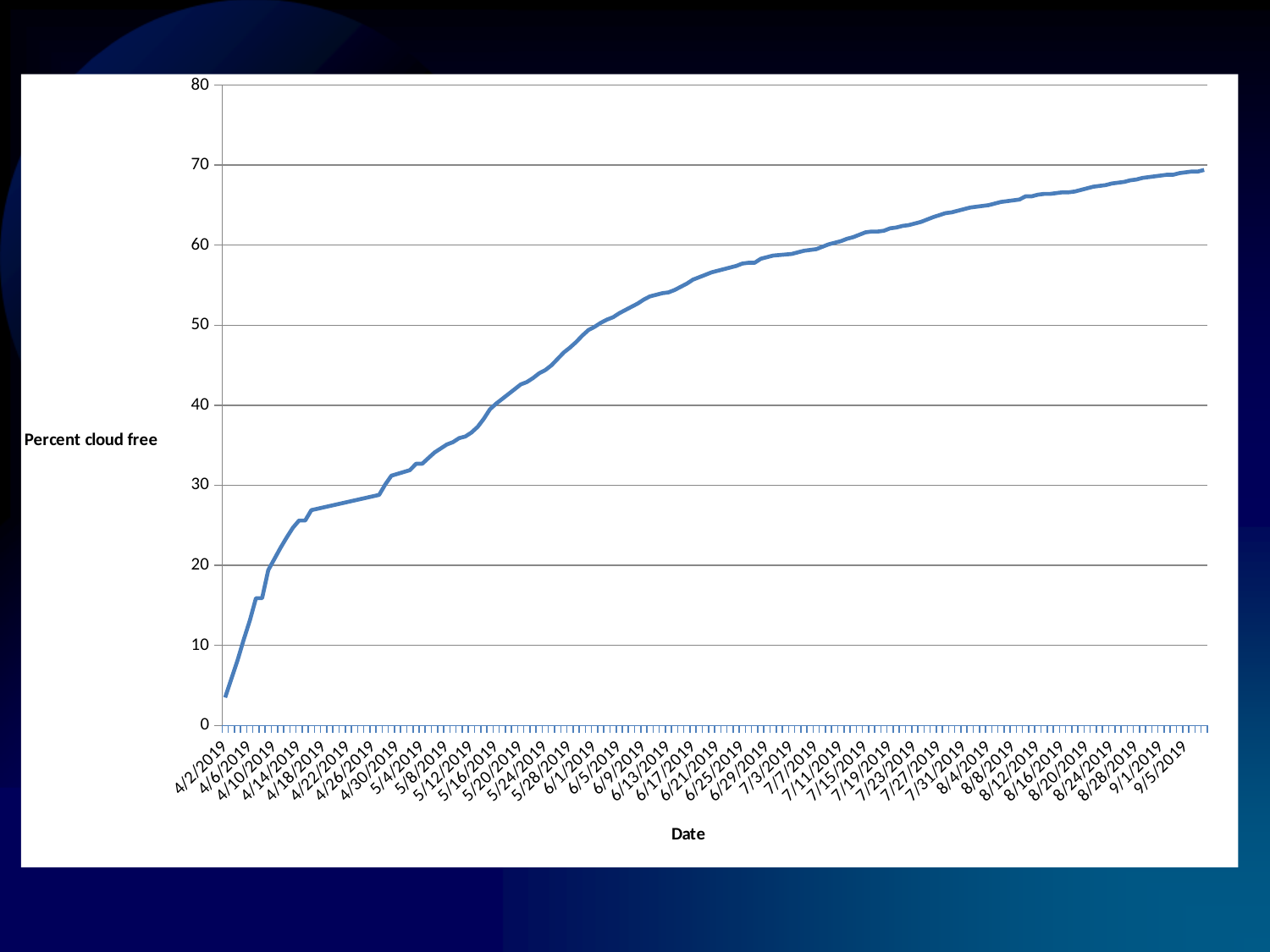
What is the label of the vertical axis? Percent cloud free Is the value for 6/21/2019 greater or less than 50? greater Is the value for 4/2/2019 greater or less than 10? less Is the value for 5/20/2019 greater or less than 30? greater What kind of chart is shown on the slide? line chart What is the label of the horizontal axis? Date Do the values rise or fall along the x axis from 4/2/2019 to 9/5/2019? rise